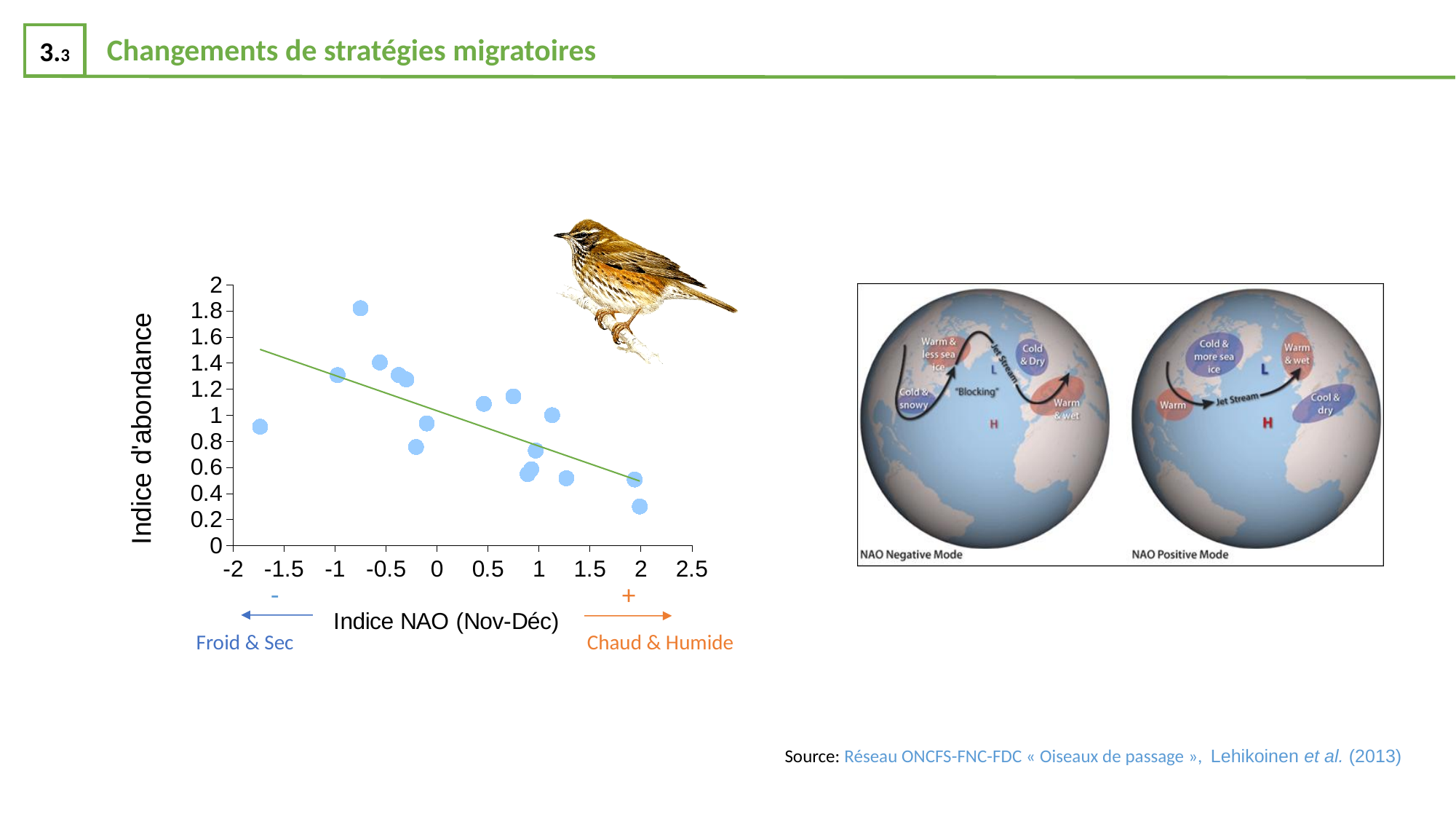
What kind of chart is shown on the slide? scatter plot What is the label of the horizontal axis of the chart? Indice NAO (Nov-Déc) Is the lowest abundance index value plotted on the chart greater or less than 0.4? less Is the abundance index of the point with the lowest NAO index (around -1.7) greater or less than 1.2? less What is the label of the vertical axis of the chart? Indice d'abondance Is the highest abundance index value plotted on the chart greater or less than 1.6? greater Does the trend line on the chart slope upward or downward from left to right? downward Do the values of the abundance index generally rise or fall as the NAO index increases along the x axis? fall Which has the higher abundance index: the point at NAO index about -0.75 or the point at NAO index about 1.25? the point at NAO index about -0.75 What is the maximum value shown on the vertical axis of the chart? 2